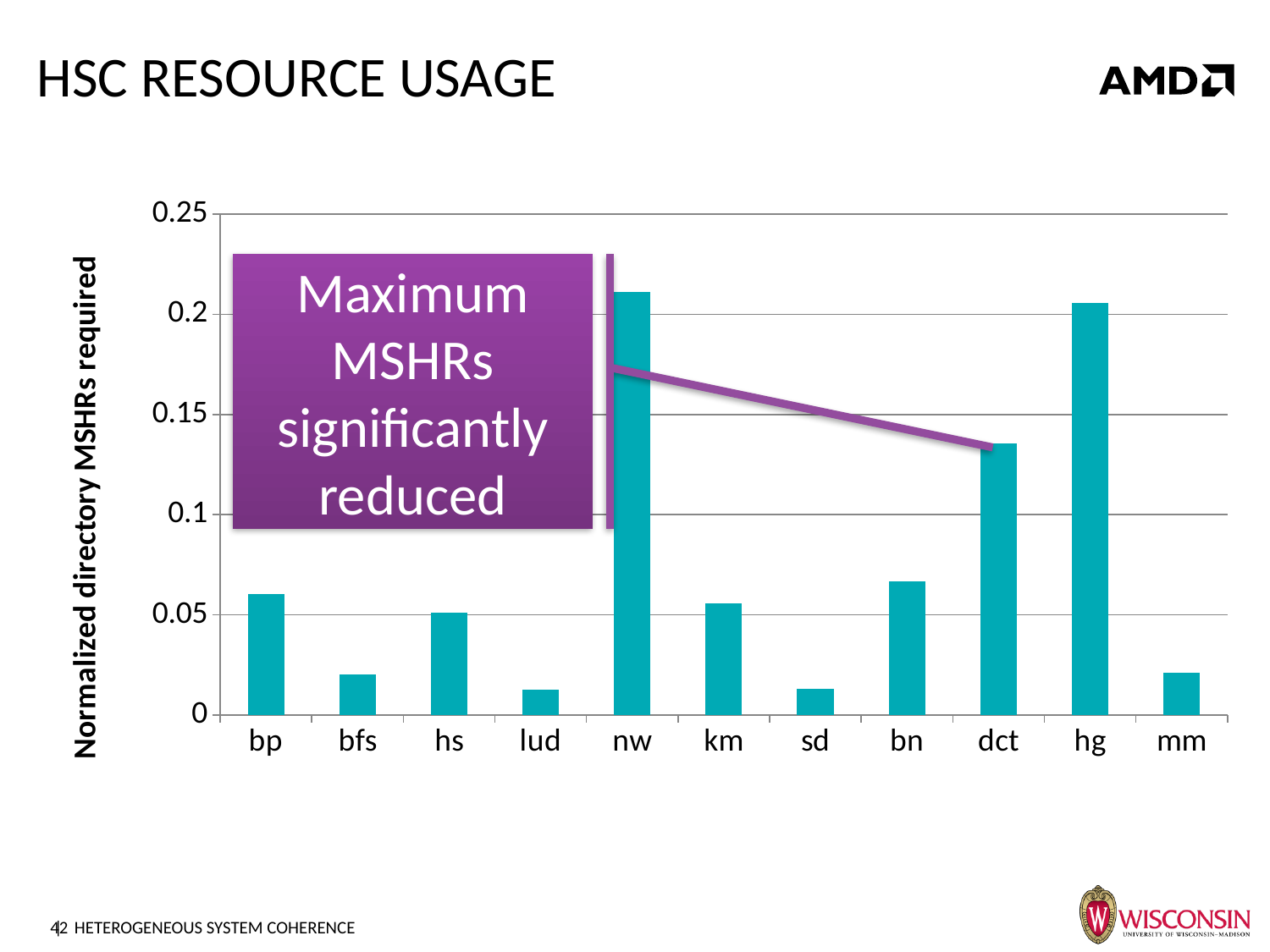
Which has the larger value, nw or dct? nw How many categories are plotted along the x axis? 11 What does the purple callout box on the chart say? Maximum MSHRs significantly reduced What kind of chart is shown on the slide? bar chart Is the value for dct greater or less than 0.1? greater Is the value for bn greater or less than 0.05? greater Is the value for bfs greater or less than 0.05? less Which has the larger value, dct or bn? dct What is the label on the y axis of the chart? Normalized directory MSHRs required Which has the larger value, bp or bfs? bp